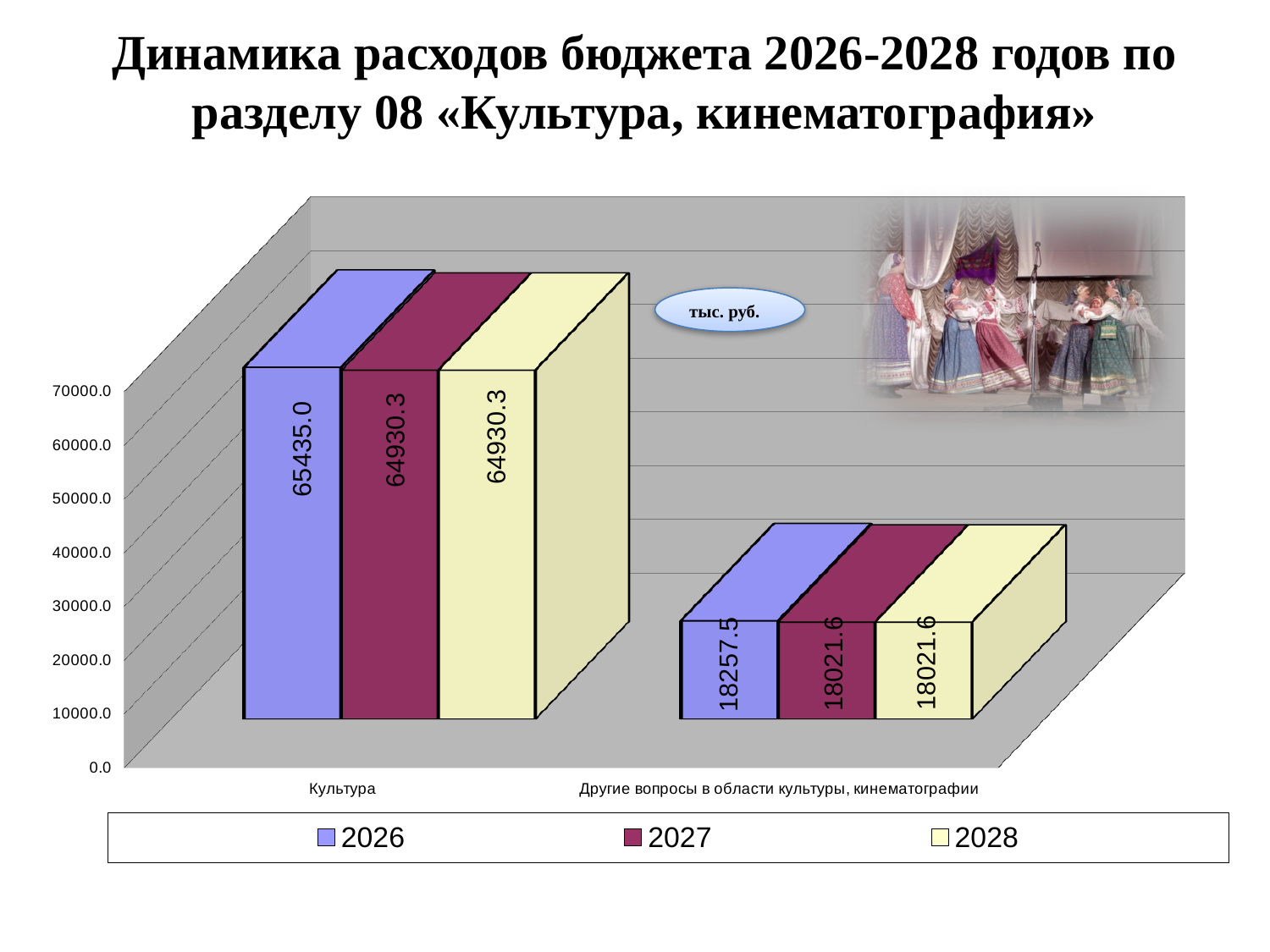
What is the value for Культура in 2026? 65435.0 What is the difference between the 2026 and 2027 values for Культура? 504.7 Which is larger: the 2026 value for Культура or the 2026 value for Другие вопросы в области культуры, кинематографии? Культура Which category has the lowest value in 2027? Другие вопросы в области культуры, кинематографии What is the value for Культура in 2027? 64930.3 What is the difference between the 2026 and 2028 values for Другие вопросы в области культуры, кинематографии? 235.9 What is the value for Другие вопросы в области культуры, кинематографии in 2026? 18257.5 How many series does the legend list? 3 What kind of chart is shown on the slide? Bar chart Which category has the highest value in 2026? Культура What is the value for Другие вопросы в области культуры, кинематографии in 2028? 18021.6 How many categories are shown on the x axis? 2